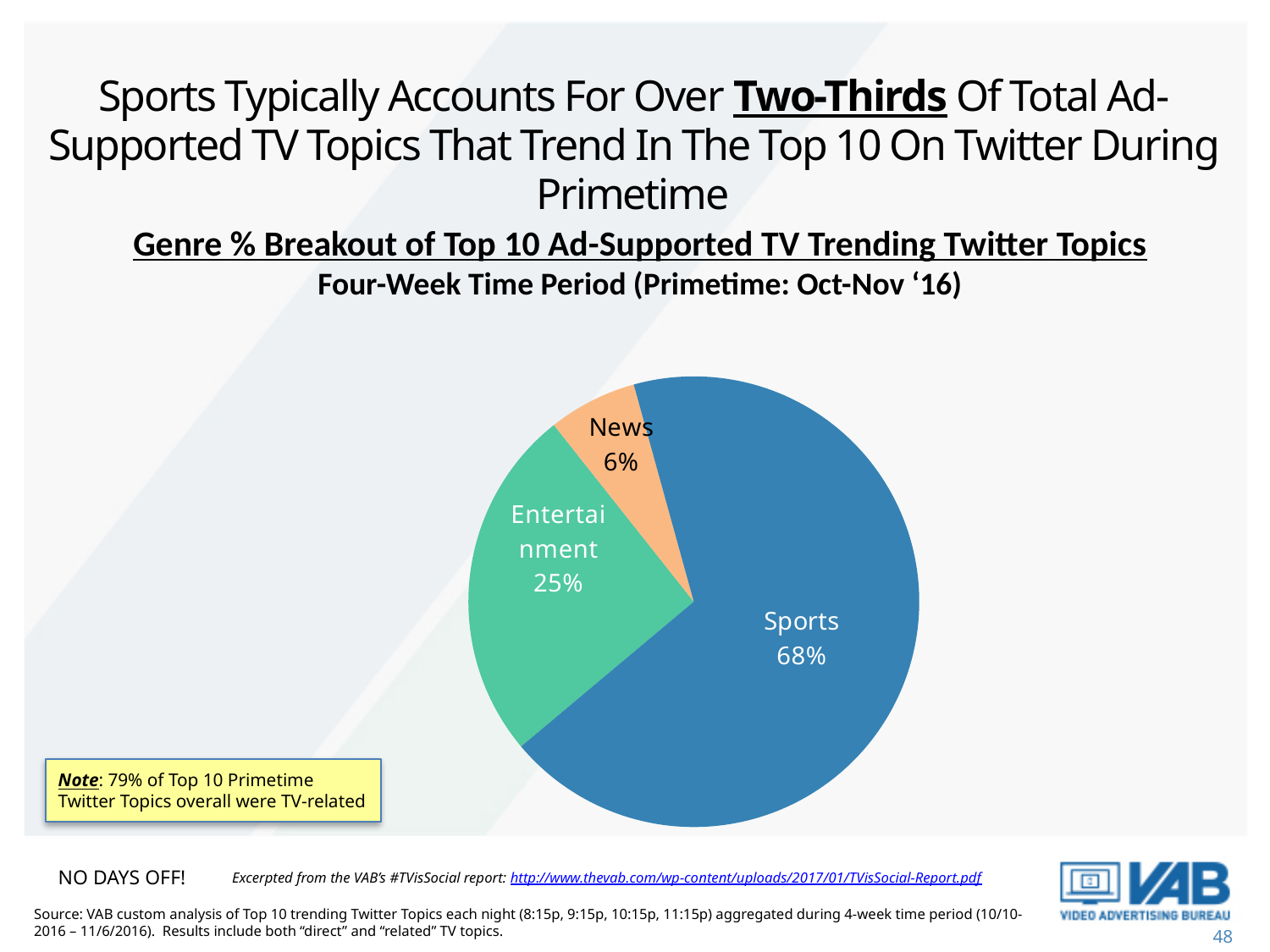
What is the difference in percentage points between Entertainment and News? 19 Which is larger, the Entertainment slice or the News slice? Entertainment What percentage is shown for Entertainment? 25% What is the difference in percentage points between Sports and Entertainment? 43 Which genre has the smallest slice of the pie? News How many genre slices does the pie chart have? 3 Which genre has the largest slice of the pie? Sports What share of the pie does Sports account for? 68% What is the title of the chart? Genre % Breakout of Top 10 Ad-Supported TV Trending Twitter Topics What colour is the Sports slice of the pie? Blue What kind of chart is shown on the slide? Pie chart What percentage is shown for News? 6%